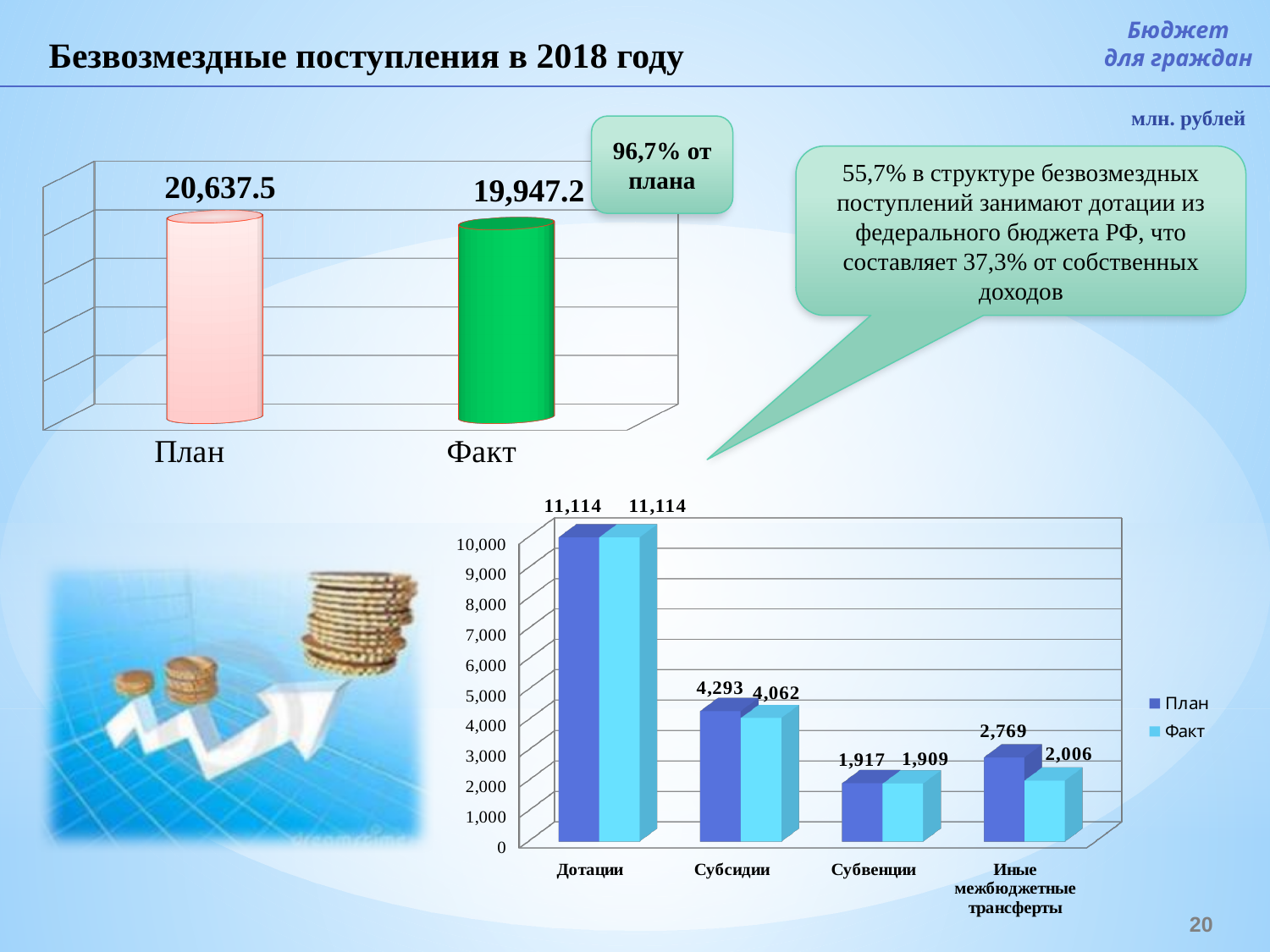
What kind of chart is the bottom chart? Bar chart In the bottom chart, what is the Факт value for Субсидии? 4,062 In the bottom chart, how many categories are shown on the x axis? 4 In the bottom chart, what is the difference between План and Факт for Иные межбюджетные трансферты? 763 In the top chart, what is the difference between План and Факт? 690.3 In the top chart, what is the value for Факт? 19,947.2 In the top chart, what is the value for План? 20,637.5 In the bottom chart, which category has the highest План value? Дотации In the bottom chart, what is the План value for Иные межбюджетные трансферты? 2,769 In the bottom chart, which category has the lowest Факт value? Субвенции In the bottom chart, how many series does the legend list? 2 In the top chart, which is larger, План or Факт? План